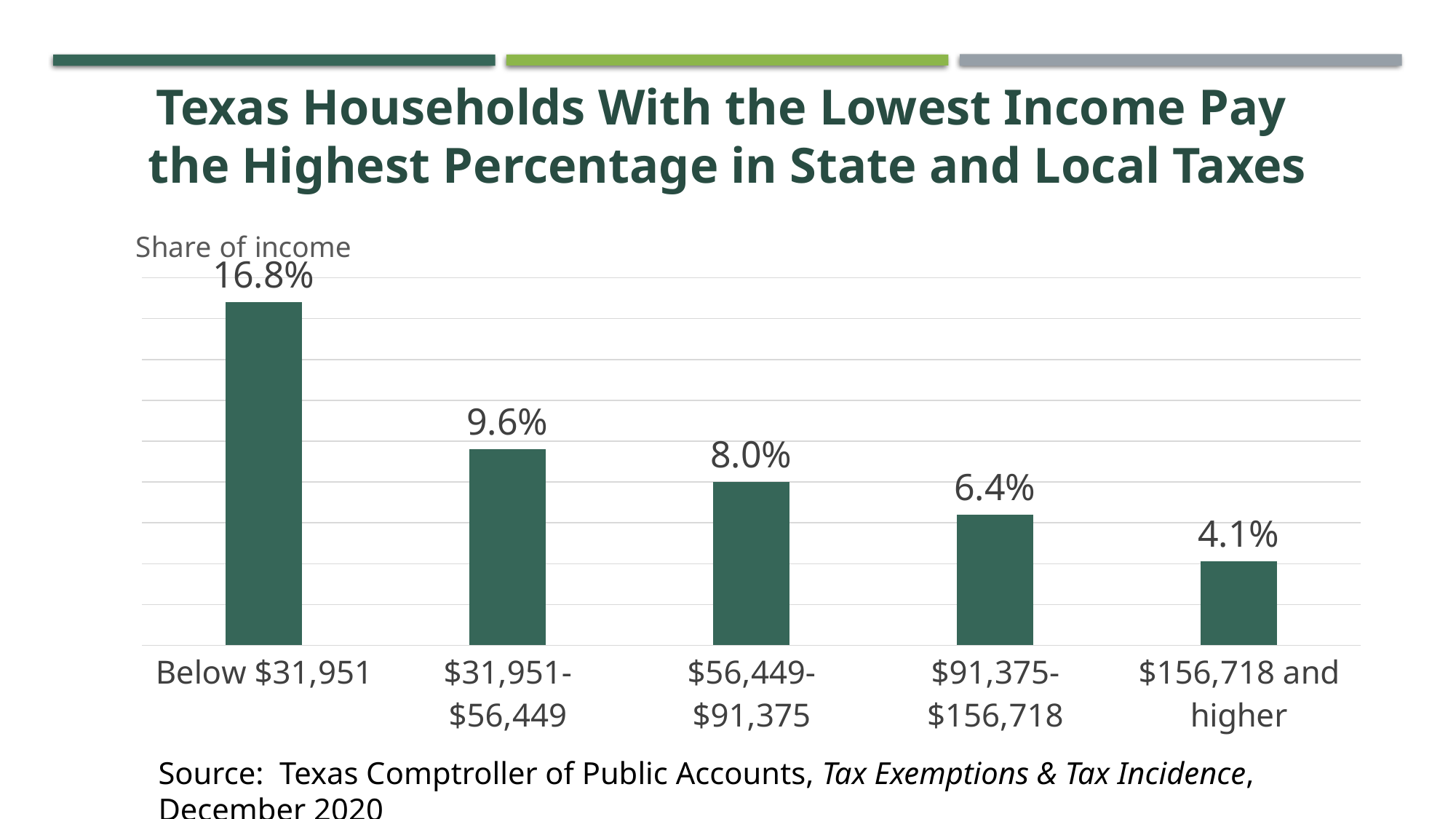
What is the value for the $31,951-$56,449 income group? 9.6% How many income groups are shown in the chart? 5 What share of income do households with income below $31,951 pay in state and local taxes? 16.8% What kind of chart is shown on the slide? Bar chart What is the value for the $56,449-$91,375 income group? 8.0% Which group pays a larger share of income: $31,951-$56,449 or $91,375-$156,718? $31,951-$56,449 Which income group pays the highest share of income in state and local taxes? Below $31,951 Which income group pays the lowest share of income in state and local taxes? $156,718 and higher What is the value for households with income of $156,718 and higher? 4.1% Do the values rise or fall as income increases along the x axis? Fall What is the difference between the share paid by the Below $31,951 group and the $156,718 and higher group? 12.7% What is the value for the $91,375-$156,718 income group? 6.4%